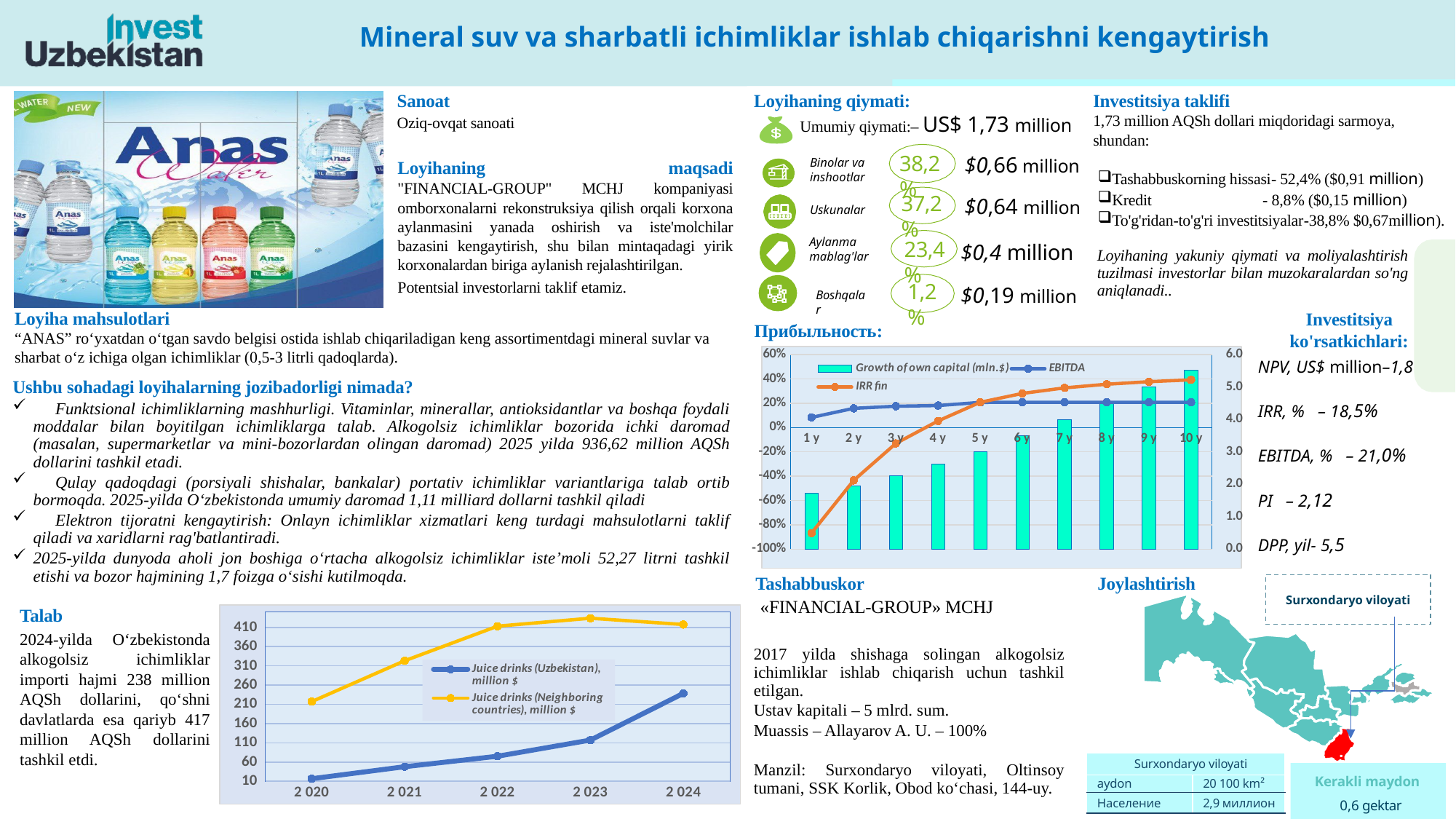
In the Talab chart, which series has the larger value in 2024: Juice drinks (Uzbekistan) or Juice drinks (Neighboring countries)? Juice drinks (Neighboring countries) In the Talab chart, do the values for Juice drinks (Uzbekistan), million $ rise or fall from 2020 to 2024? rise How many series does the legend of the Talab chart list? 2 What kind of chart is the Talab chart at the bottom left of the slide? line chart How many years are shown on the x axis of the Talab chart? 5 In the Прибыльность chart, does the IRR fin line rise or fall from 1 y to 10 y? rise How many years are shown on the x axis of the Прибыльность chart? 10 In the Talab chart, is the 2020 value for Juice drinks (Neighboring countries), million $ greater or less than 260? less In the Talab chart, is the 2024 value for Juice drinks (Uzbekistan), million $ greater or less than 160? greater In the Прибыльность chart, is the IRR fin value at 1 y greater or less than -60%? less In the Прибыльность chart, which year has the highest bar for Growth of own capital (mln.$)? 10 y How many series does the legend of the Прибыльность chart list? 3